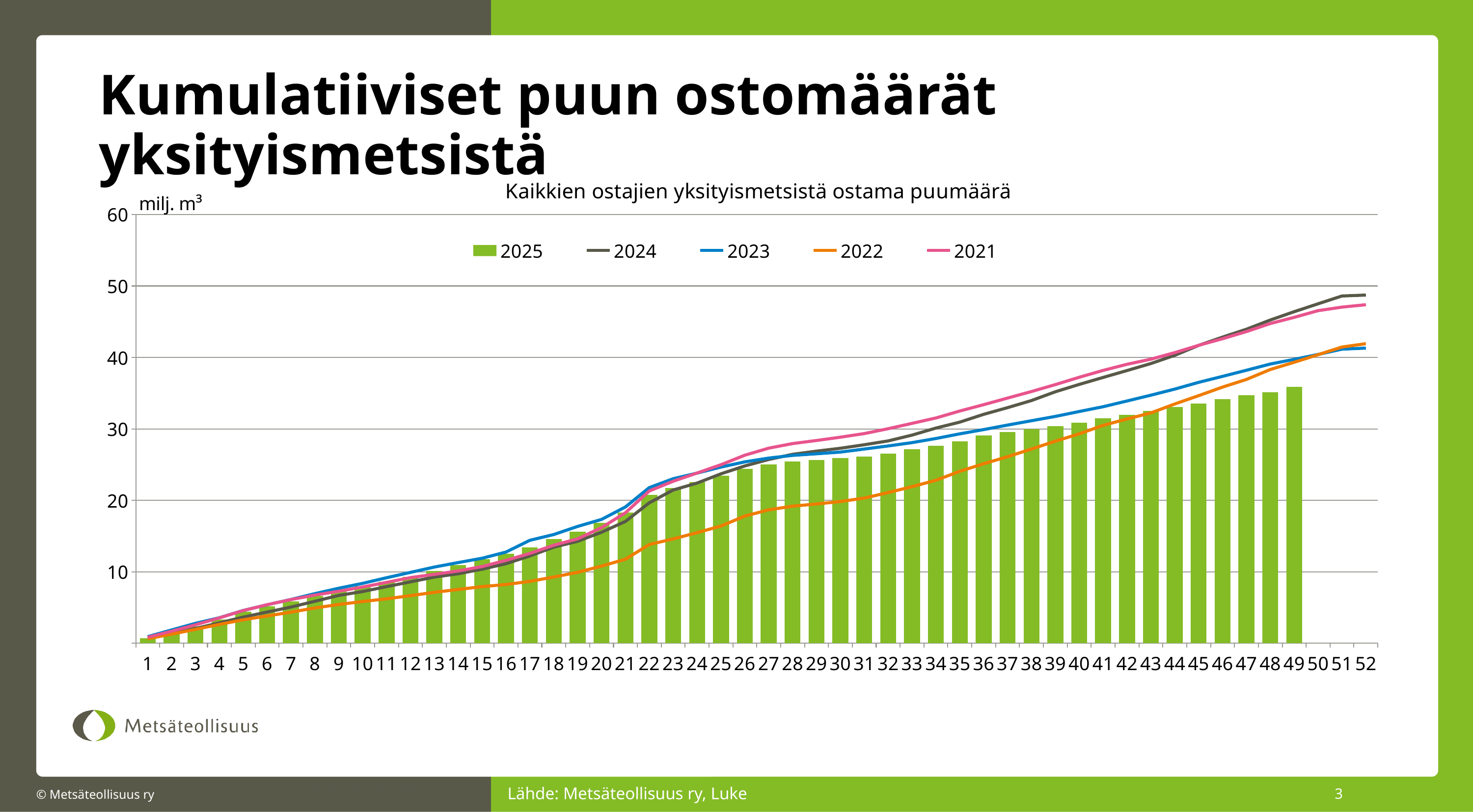
What kind of chart is shown on the slide? A combined bar and line chart At week 30, which series has the lowest value? 2022 Do the values of the 2025 bars rise or fall from week 1 to week 49? Rise Is the value of the 2021 line at week 52 greater or less than 40? greater Which series is drawn as bars rather than a line? 2025 Is the value of the 2025 bar at week 49 greater or less than 30? greater How many series does the chart legend list? 5 What is the title printed above the chart? Kaikkien ostajien yksityismetsistä ostama puumäärä Is the value of the 2024 line at week 52 greater or less than 50? less At week 49, which is larger: the 2025 bar or the 2024 line? The 2024 line At week 52, which series has the highest value? 2024